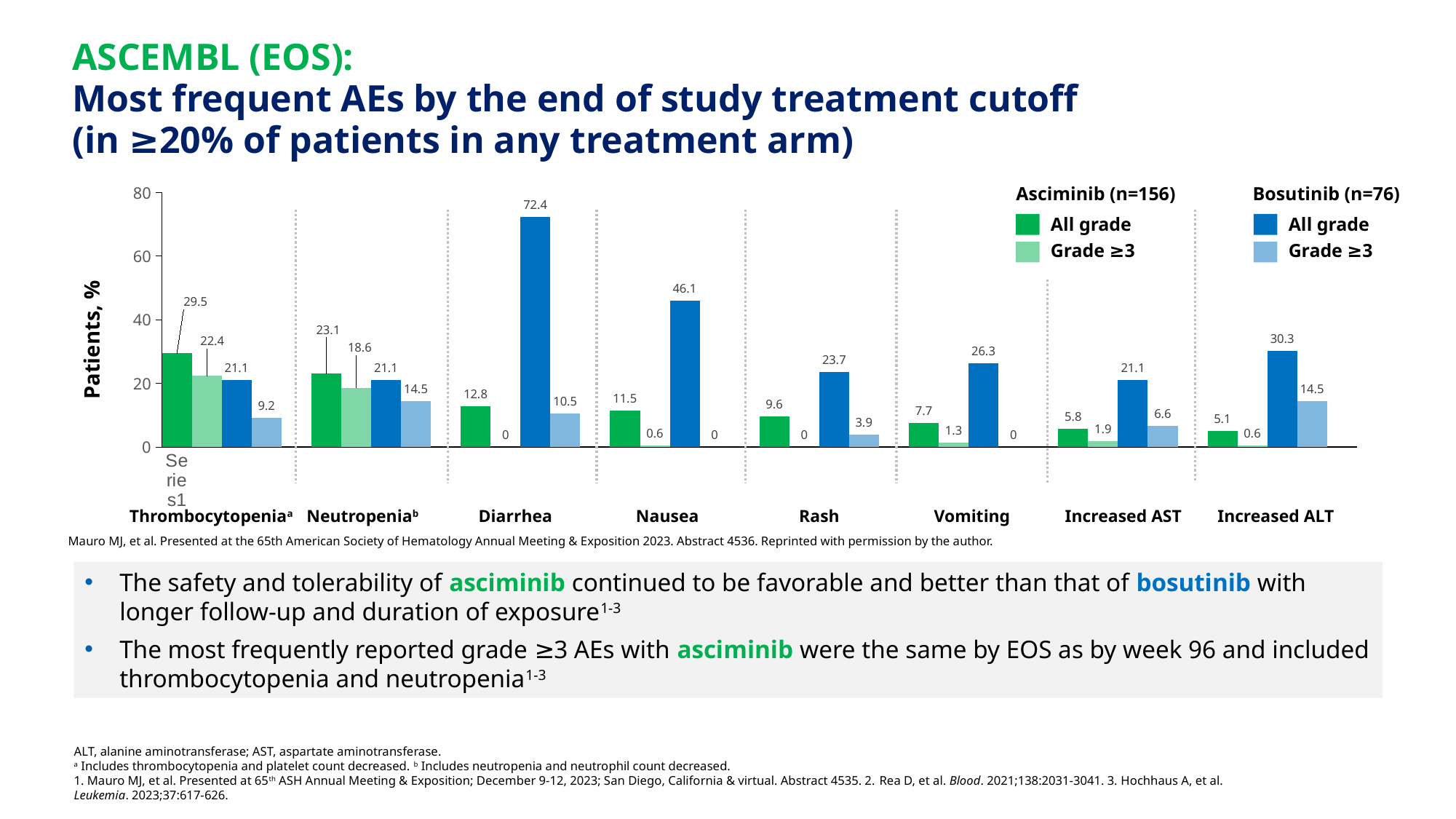
How many series does the legend list? 4 What is the difference between the bosutinib all-grade and asciminib all-grade rates for nausea? 34.6 How many adverse event categories are shown on the x axis? 8 Which adverse event has the lowest all-grade rate with asciminib? Increased ALT What is the grade ≥3 rate of neutropenia with asciminib? 18.6 What kind of chart is shown on the slide? Bar chart Which adverse event has the highest all-grade rate with bosutinib? Diarrhea What is the all-grade rate of thrombocytopenia with asciminib? 29.5 What is the all-grade rate of diarrhea with bosutinib? 72.4 What is the grade ≥3 rate of increased ALT with bosutinib? 14.5 What is the label of the y axis? Patients, % Which is larger for thrombocytopenia: the asciminib all-grade rate or the bosutinib all-grade rate? Asciminib all grade